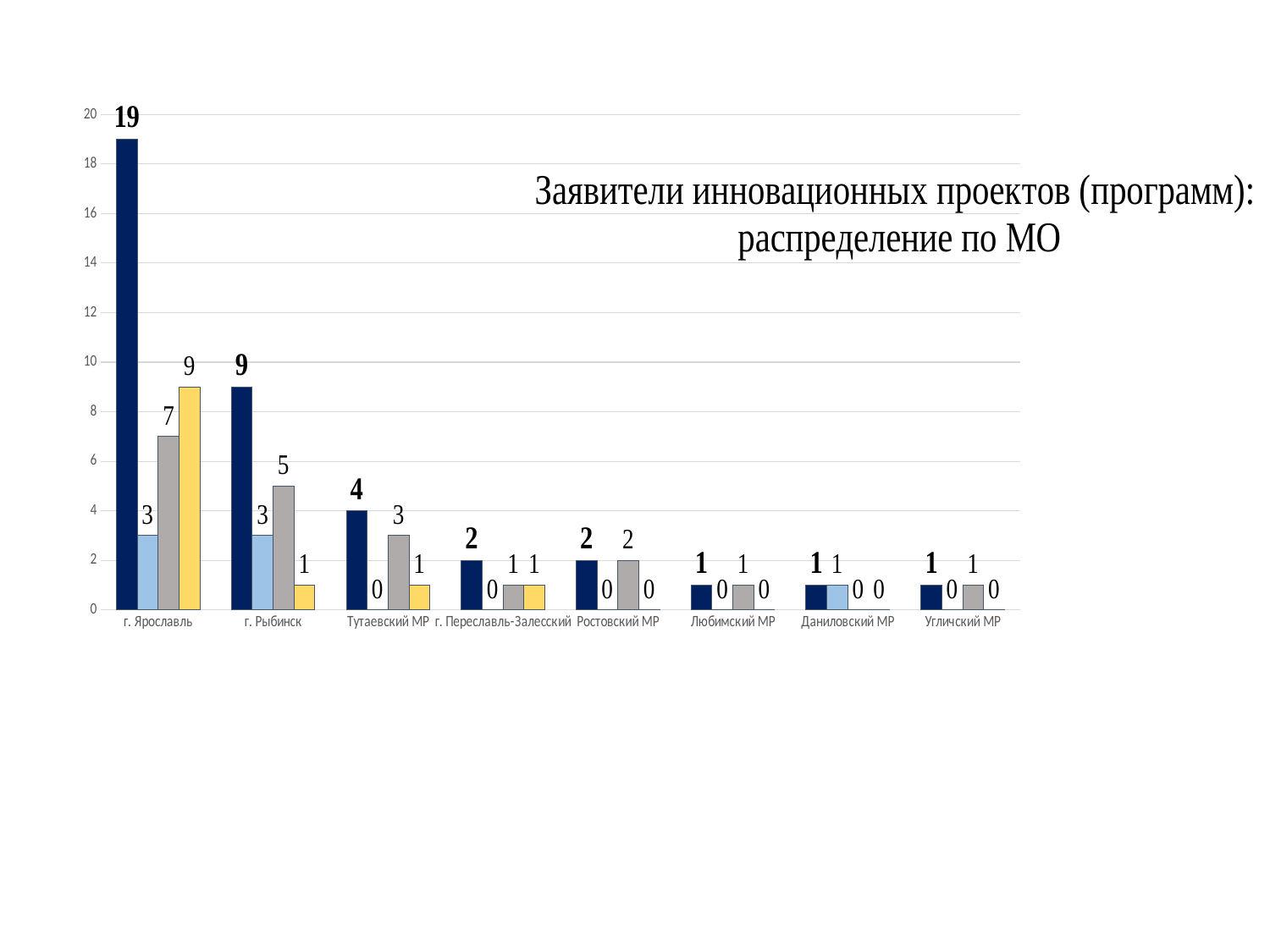
What is the value of the yellow bar for г. Ярославль? 9 Do the dark blue bars rise or fall from left to right along the x axis? fall What kind of chart is shown on the slide? bar chart What is the value of the light blue bar for Даниловский МР? 1 What is the value of the grey bar for г. Рыбинск? 5 Which is larger for г. Ярославль: the grey bar or the yellow bar? the yellow bar Which category has the highest dark blue bar? г. Ярославль How many categories are shown on the x axis? 8 What is the difference between the dark blue bars for г. Ярославль and г. Рыбинск? 10 What is the title of the chart? Заявители инновационных проектов (программ): распределение по МО What is the value of the dark blue bar for г. Ярославль? 19 What is the value of the grey bar for Тутаевский МР? 3